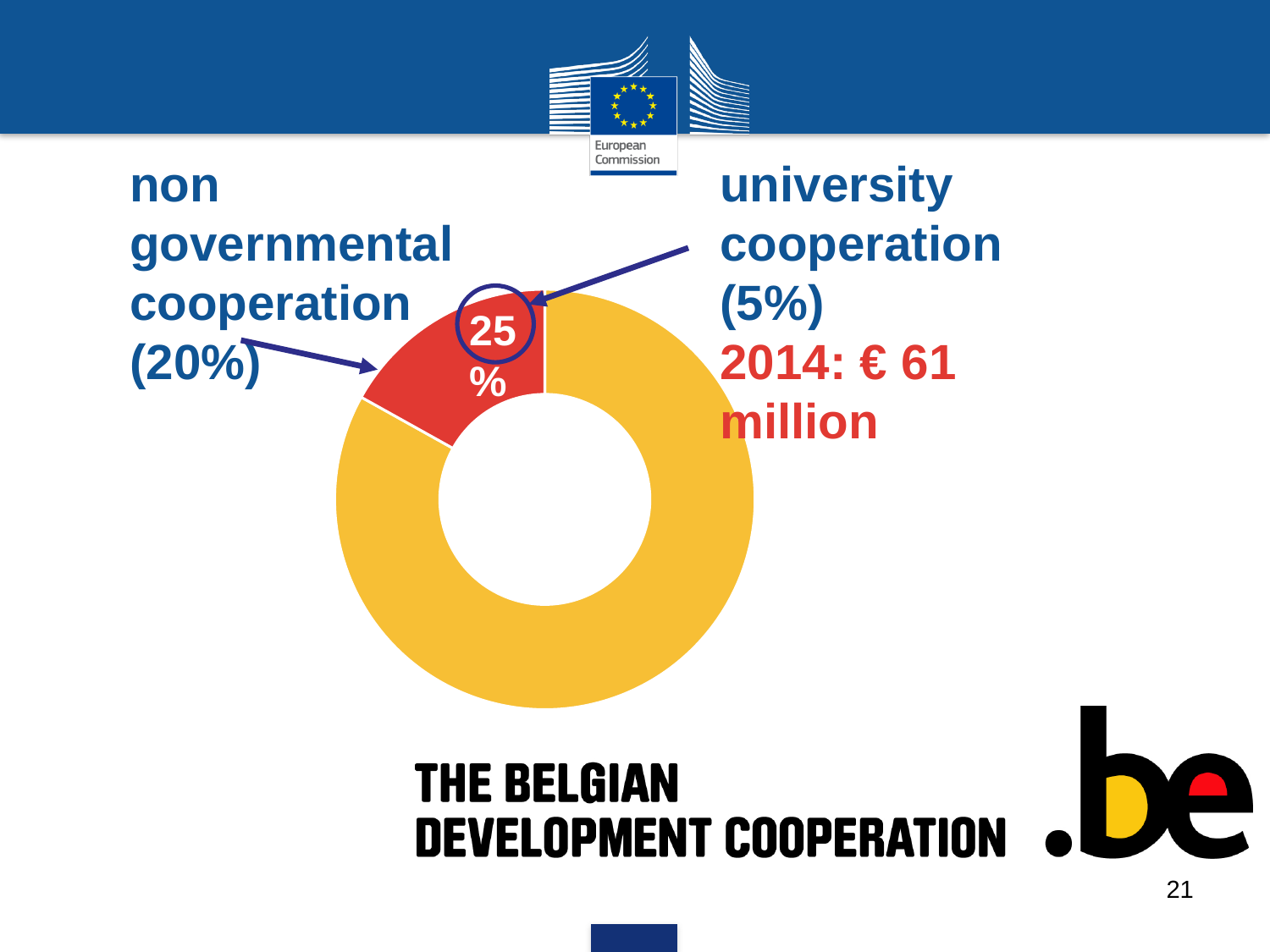
What share of the doughnut does the red slice represent? 25% What amount is given for 2014 next to the chart? € 61 million What colour is the slice labelled 25%? red What percentage is printed on the red slice of the doughnut chart? 25% According to the annotation, what percentage is attributed to university cooperation? 5% Which of the two annotated components is larger, non governmental cooperation or university cooperation? non governmental cooperation How many slices does the doughnut chart have? 2 What is the difference between the non governmental cooperation share (20%) and the university cooperation share (5%)? 15% According to the annotation, what percentage is attributed to non governmental cooperation? 20% Which slice of the doughnut chart is larger, the yellow one or the red one? the yellow one What is the combined share of non governmental cooperation (20%) and university cooperation (5%)? 25% What kind of chart is shown on the slide? doughnut (pie) chart